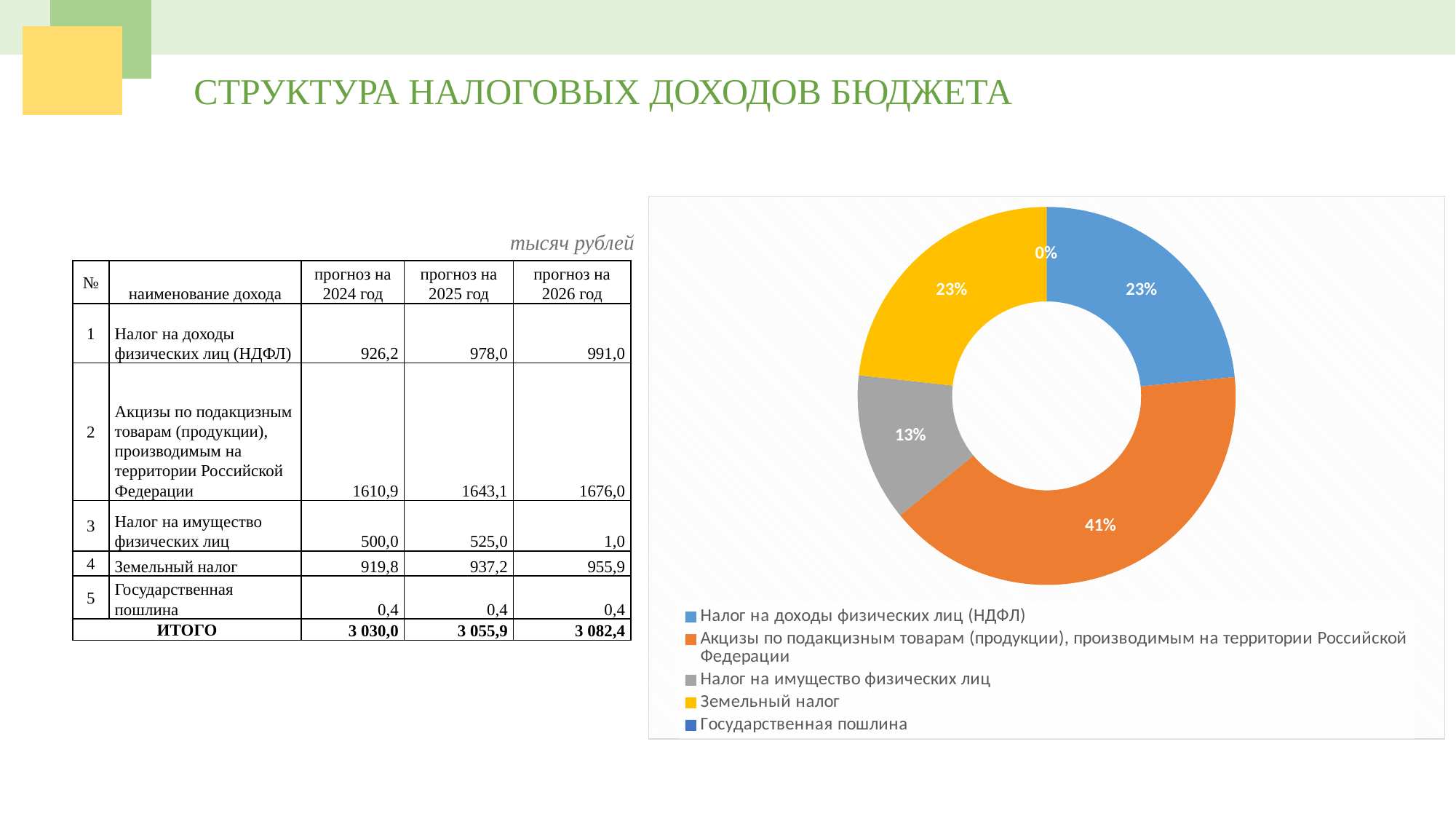
What percentage is shown for "Акцизы по подакцизным товарам (продукции), производимым на территории Российской Федерации" in the chart? 41% What percentage is shown for "Земельный налог" in the chart? 23% Which category has the largest share in the chart? Акцизы по подакцизным товарам (продукции), производимым на территории Российской Федерации What kind of chart is shown on the slide? doughnut chart What percentage is shown for "Налог на имущество физических лиц" in the chart? 13% What percentage is shown for "Государственная пошлина" in the chart? 0% What colour is the "Земельный налог" slice in the chart? yellow Which category has the smallest share in the chart? Государственная пошлина What share of the doughnut chart does "Налог на доходы физических лиц (НДФЛ)" have? 23% How many categories are shown in the chart's legend? 5 Which has a larger share in the chart: "Акцизы по подакцизным товарам" or "Налог на доходы физических лиц (НДФЛ)"? Акцизы по подакцизным товарам What is the difference in percentage points between the share of "Акцизы по подакцизным товарам" and the share of "Налог на имущество физических лиц"? 28 percentage points